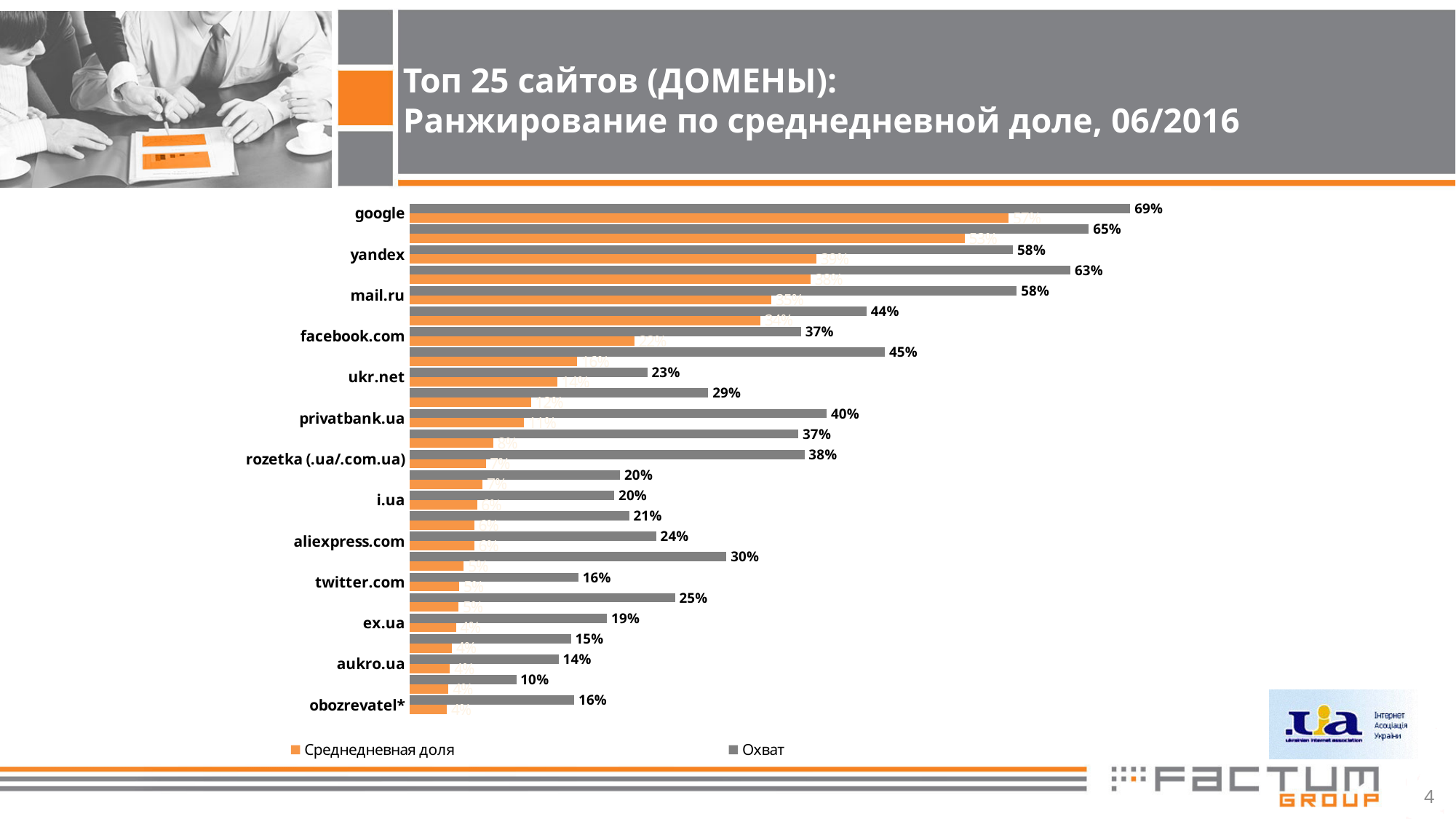
Which has the larger Охват value, privatbank.ua or facebook.com? privatbank.ua What is the Охват value for privatbank.ua? 40% What is the Охват value for facebook.com? 37% Which site has the highest Охват value? google How many series does the legend list? 2 What is the Охват value for aukro.ua? 14% What is the Охват value for aliexpress.com? 24% What is the difference between the Охват values for google and yandex? 11 percentage points Which colour represents the Охват series? Grey What is the Охват value for google? 69% What kind of chart is shown on the slide? Bar chart Which has the larger Охват value, ukr.net or rozetka (.ua/.com.ua)? rozetka (.ua/.com.ua)